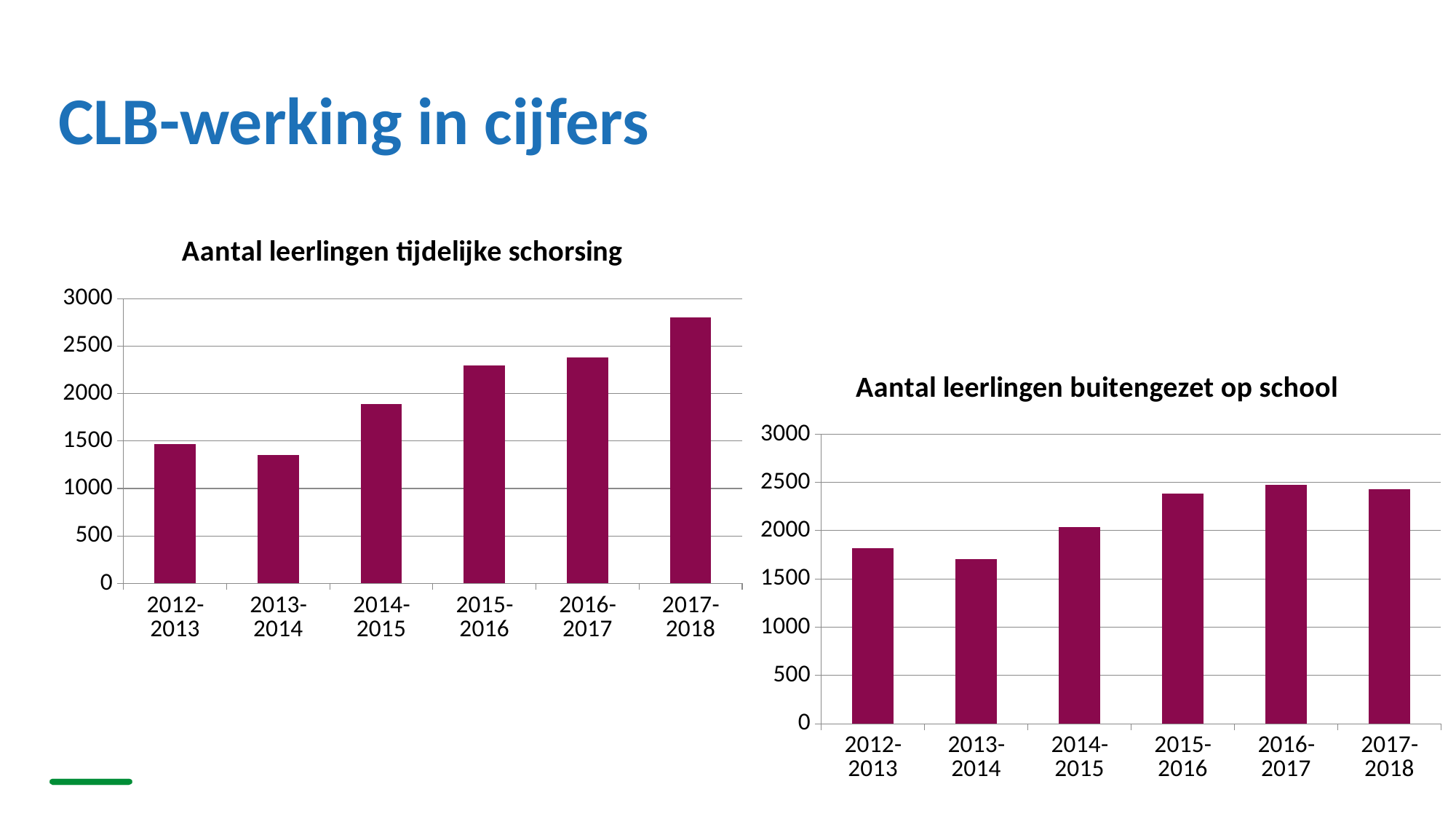
How many school years are shown in the chart 'Aantal leerlingen tijdelijke schorsing'? 6 In the chart 'Aantal leerlingen tijdelijke schorsing', which school year has the highest value? 2017-2018 In the chart 'Aantal leerlingen tijdelijke schorsing', is the value for 2013-2014 greater or less than 1500? less In the chart 'Aantal leerlingen buitengezet op school', which is larger: the value for 2012-2013 or the value for 2015-2016? 2015-2016 In the chart 'Aantal leerlingen buitengezet op school', which school year has the lowest value? 2013-2014 In the chart 'Aantal leerlingen tijdelijke schorsing', which school year has the lowest value? 2013-2014 What kind of chart is 'Aantal leerlingen buitengezet op school'? bar chart In the chart 'Aantal leerlingen buitengezet op school', is the value for 2013-2014 greater or less than 2000? less In the chart 'Aantal leerlingen tijdelijke schorsing', is the value for 2017-2018 greater or less than 2500? greater In the chart 'Aantal leerlingen tijdelijke schorsing', which is larger: the value for 2014-2015 or the value for 2015-2016? 2015-2016 In the chart 'Aantal leerlingen tijdelijke schorsing', do the values generally rise or fall from 2013-2014 to 2017-2018? rise